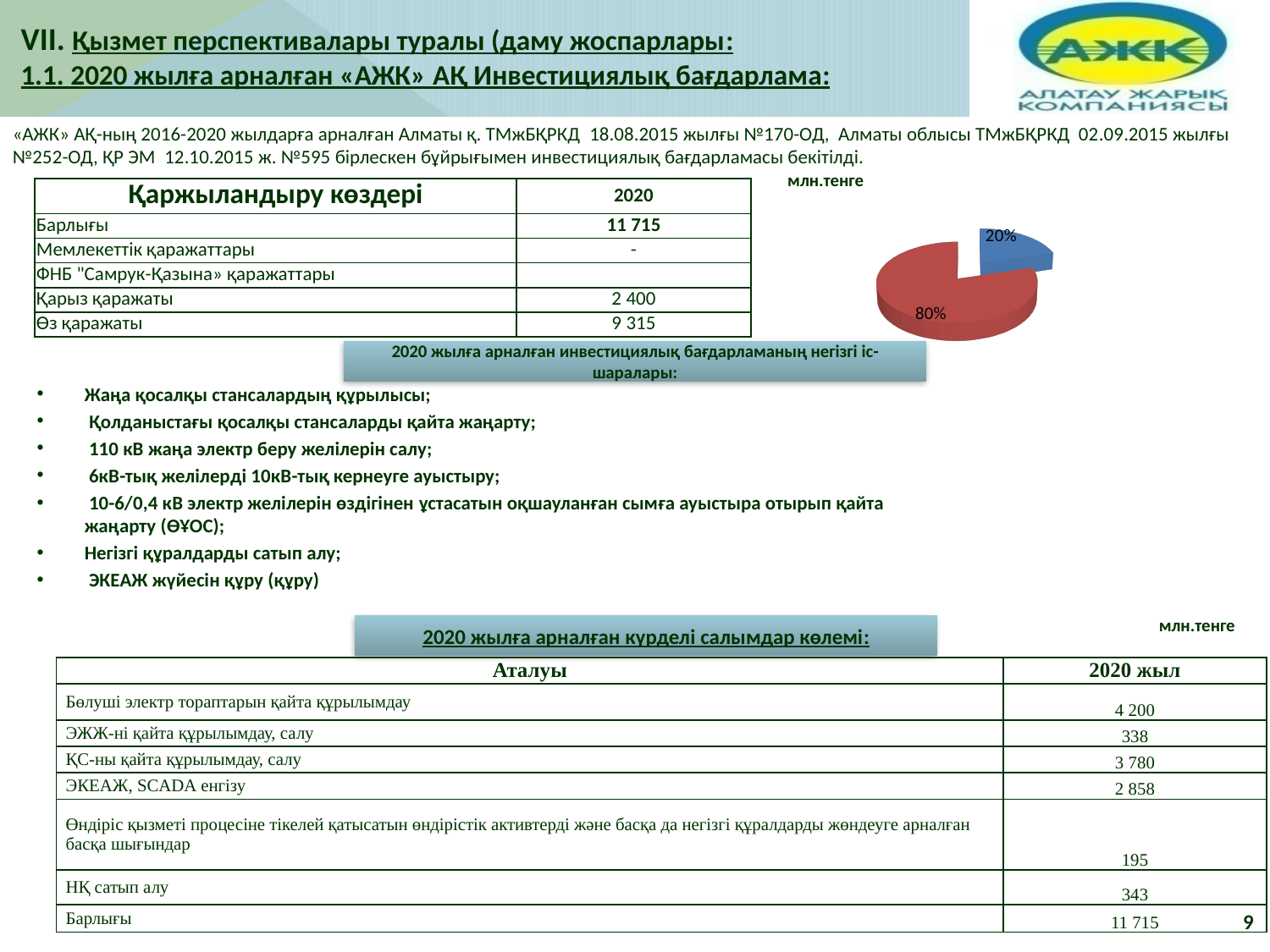
What unit label is printed above the pie chart? млн.тенге What percentage is labelled on the blue slice of the pie chart? 20% Is the share of the red slice greater or less than 50%? greater What is the difference in percentage points between the two slices of the pie chart? 60 What share of the pie does the largest slice represent? 80% Which slice of the pie chart is larger, the red one or the blue one? red Is the share of the blue slice greater or less than 50%? less What colour is the 80% slice of the pie chart? red What percentage is labelled on the red slice of the pie chart? 80% What share of the pie does the smallest slice represent? 20% What kind of chart is shown next to the 'Қаржыландыру көздері' table? pie chart How many slices does the pie chart have? 2